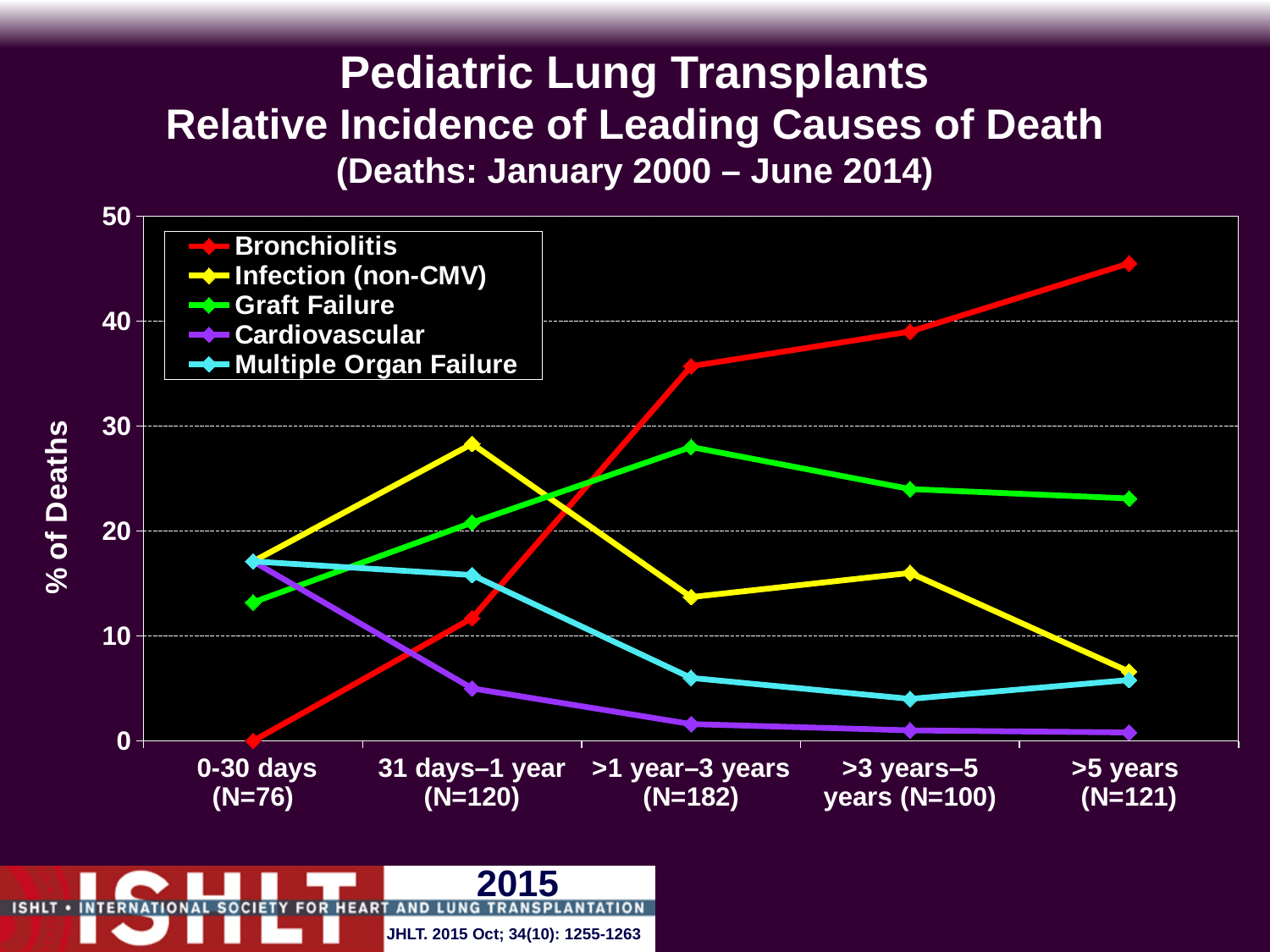
Is the value for Bronchiolitis at >5 years greater or less than 40? greater Is the value for Cardiovascular at >5 years greater or less than 10? less At >1 year–3 years, which is larger: Bronchiolitis or Graft Failure? Bronchiolitis What is the label of the y axis? % of Deaths Which cause of death has the highest value at 31 days–1 year? Infection (non-CMV) Which cause of death has the lowest value at >5 years? Cardiovascular Is the value for Graft Failure at >1 year–3 years greater or less than 20? greater How many series does the legend list? 5 Does the Bronchiolitis line rise or fall from 0-30 days to >5 years? rise What kind of chart is shown on the slide? line chart Which cause of death has the highest value at >5 years? Bronchiolitis How many time-period categories are shown on the x axis? 5